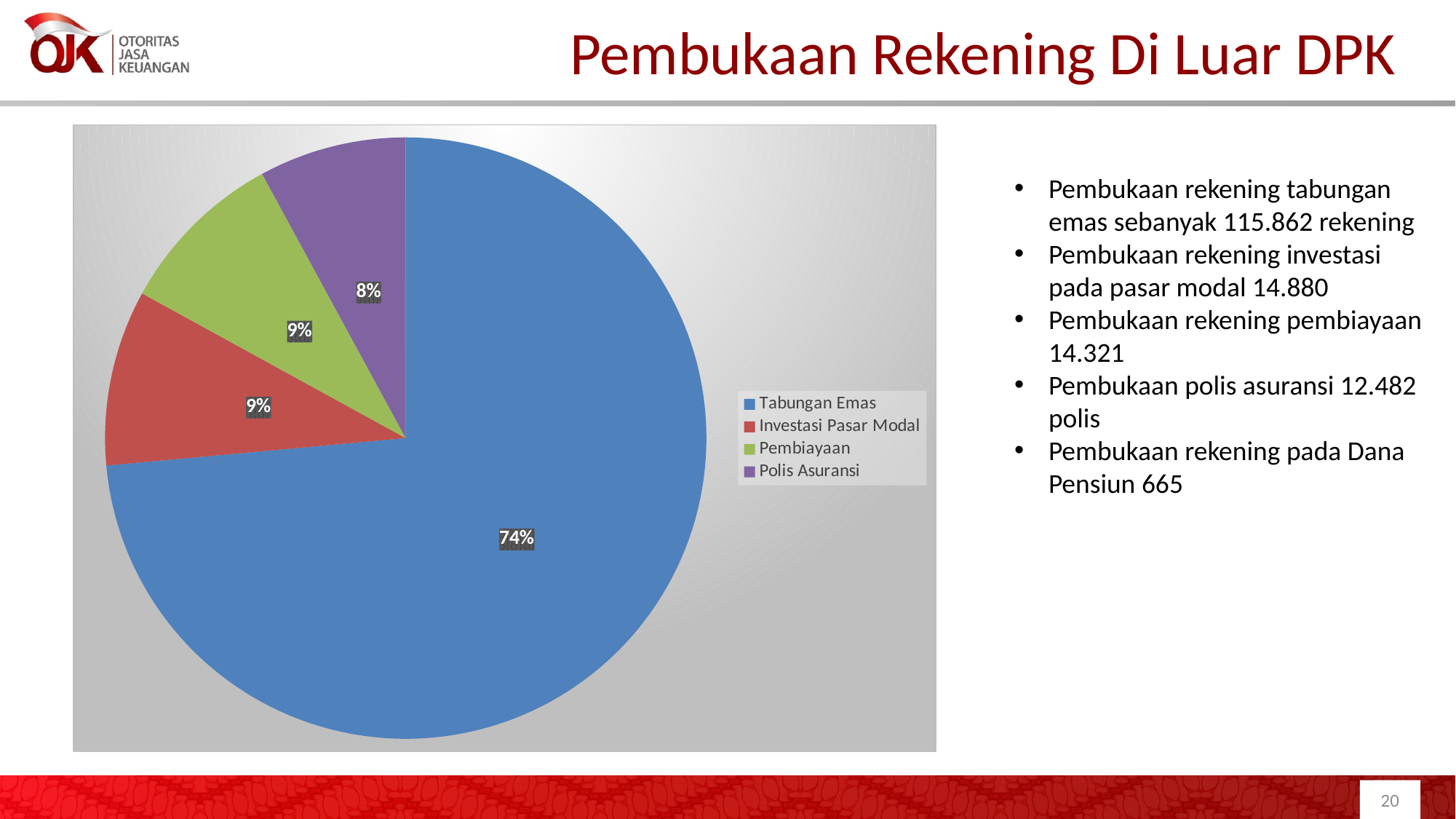
What percentage of the pie chart does Tabungan Emas account for? 74% Which colour represents Pembiayaan in the pie chart legend? Green What percentage is shown for Pembiayaan in the pie chart? 9% Which slice is larger, Tabungan Emas or Pembiayaan? Tabungan Emas What percentage is shown for Polis Asuransi in the pie chart? 8% Which category has the smallest slice of the pie chart? Polis Asuransi What percentage is shown for Investasi Pasar Modal in the pie chart? 9% What share of the pie does the Tabungan Emas slice represent? 74% Which category has the largest slice of the pie chart? Tabungan Emas What type of chart is shown on the slide? Pie chart What is the difference in percentage points between the Tabungan Emas slice and the Polis Asuransi slice? 66 percentage points How many categories are shown in the pie chart? 4